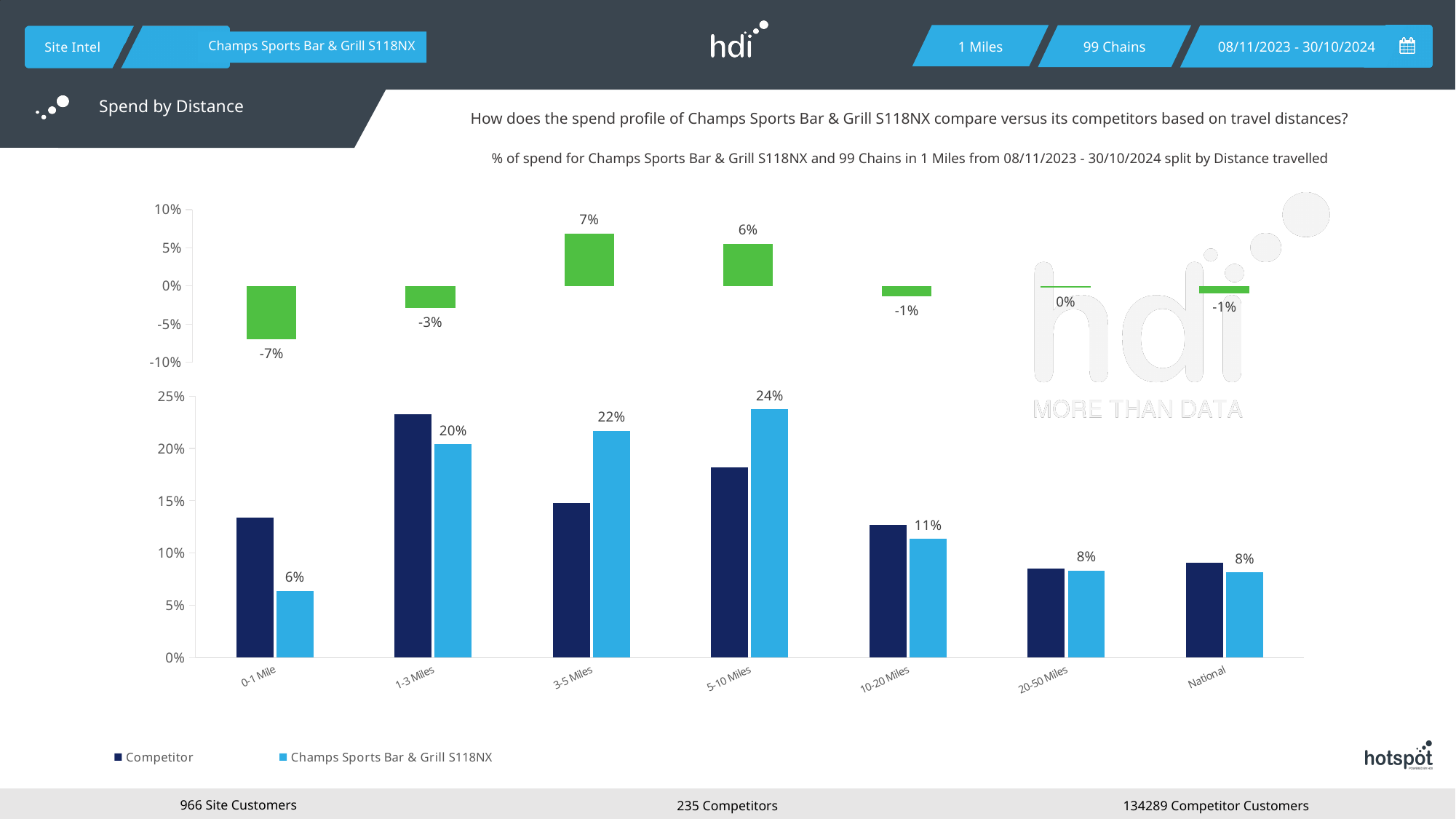
In the bottom chart, is the Competitor value at 20-50 Miles greater or less than 10%? less In the top chart, what is the value shown for 0-1 Mile? -7% In the bottom chart, what is the difference between the Champs Sports Bar & Grill S118NX values at 5-10 Miles and 10-20 Miles? 13% How many distance categories are shown on the x axis of the bottom chart? 7 In the bottom chart, which is larger at 0-1 Mile: the Competitor bar or the Champs Sports Bar & Grill S118NX bar? Competitor How many series does the legend of the bottom chart list? 2 In the bottom chart, what is the value for Champs Sports Bar & Grill S118NX at 0-1 Mile? 6% In the bottom chart, which distance band has the lowest value for Champs Sports Bar & Grill S118NX? 0-1 Mile In the bottom chart, is the Competitor value at 1-3 Miles greater or less than 20%? greater In the bottom chart, what is the value for Champs Sports Bar & Grill S118NX at 5-10 Miles? 24% In the top chart, which distance band has the highest value? 3-5 Miles In the bottom chart, which distance band has the highest value for Champs Sports Bar & Grill S118NX? 5-10 Miles